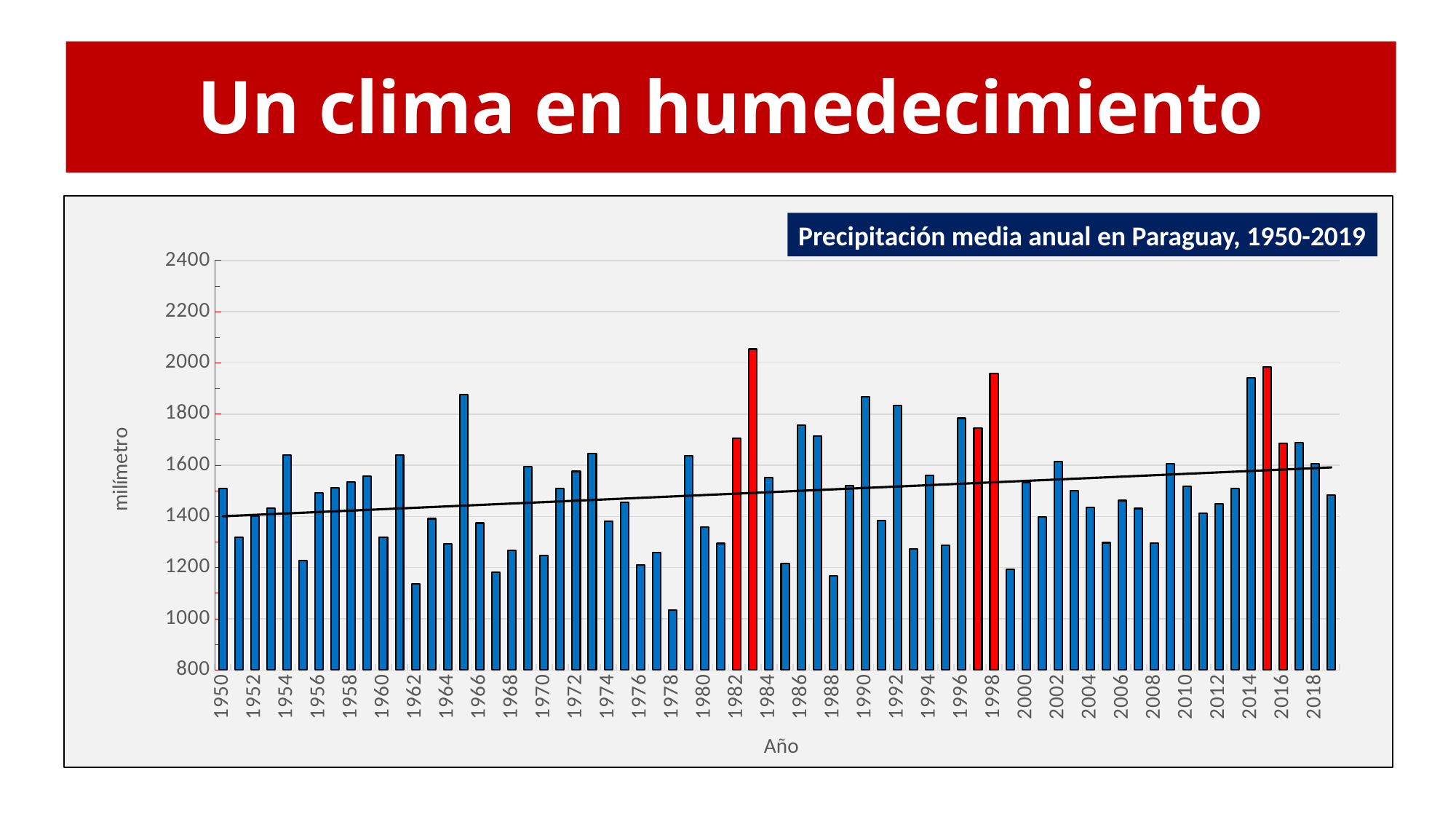
What is the title of the chart? Precipitación media anual en Paraguay, 1950-2019 Which year has the lowest precipitation bar? 1978 What kind of chart is shown on the slide? bar chart Which year has the larger value, 1954 or 1955? 1954 Which year has the highest precipitation bar? 1983 Which year has the larger value, 1983 or 1998? 1983 Is the value for 1965 greater or less than 1800? greater How many years (bars) are plotted in the chart? 70 Does the trend line show precipitation rising or falling from 1950 to 2019? rising What is the label on the vertical axis of the chart? milímetro Is the value for 1983 greater or less than 2000? greater Is the value for 1978 greater or less than 1200? less